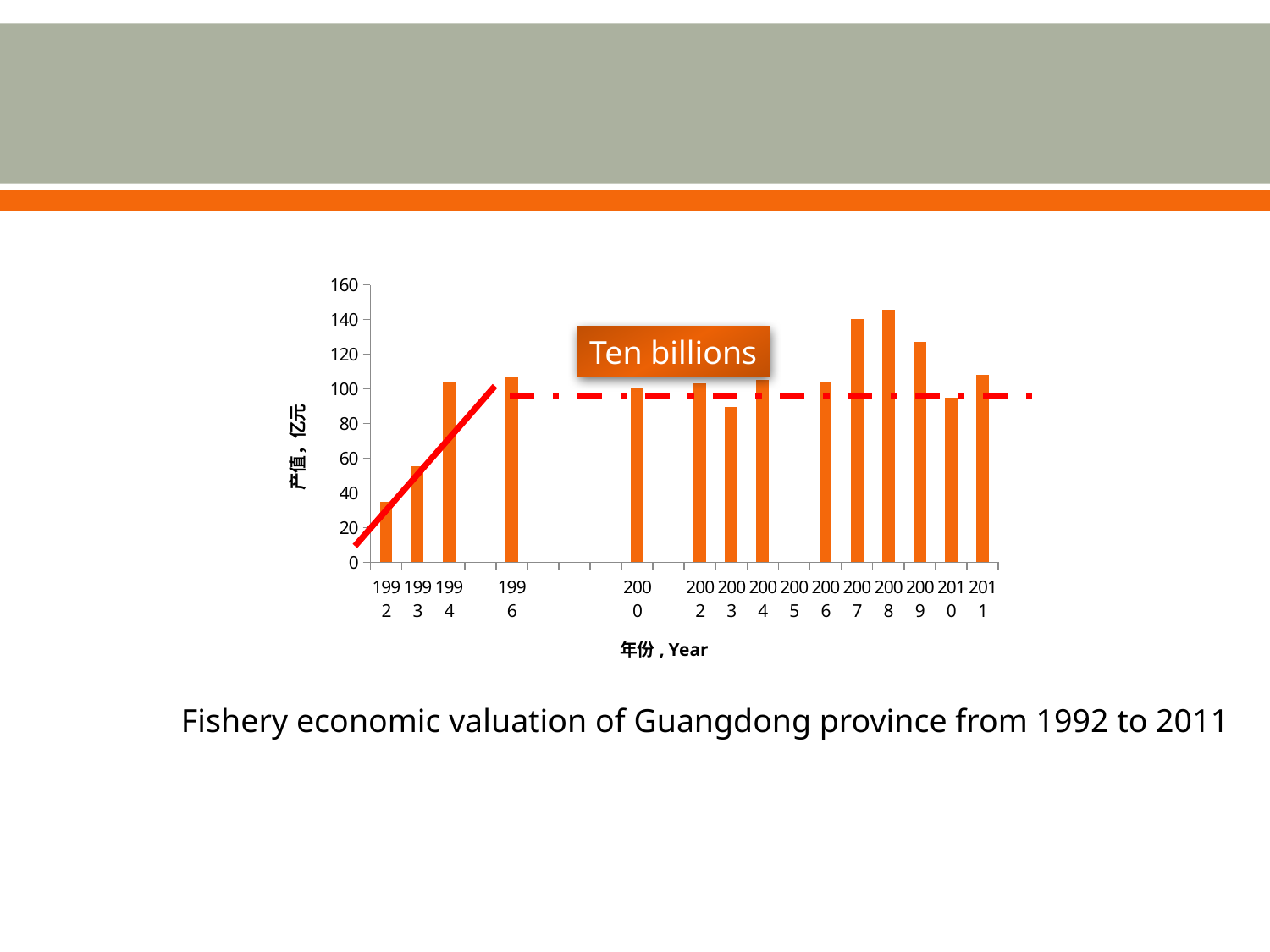
What is the x-axis title of the chart? 年份, Year Which year has the lowest fishery economic valuation? 1992 Do the values rise or fall from 1992 to 1994? rise What kind of chart is shown on the slide? bar chart Which is larger, the value for 1993 or the value for 1994? 1994 Which is larger, the value for 2007 or the value for 2003? 2007 Is the value for 2009 greater or less than 120? greater Which year has the highest fishery economic valuation? 2008 Is the value for 1994 greater or less than 80? greater Is the value for 2003 greater or less than 100? less